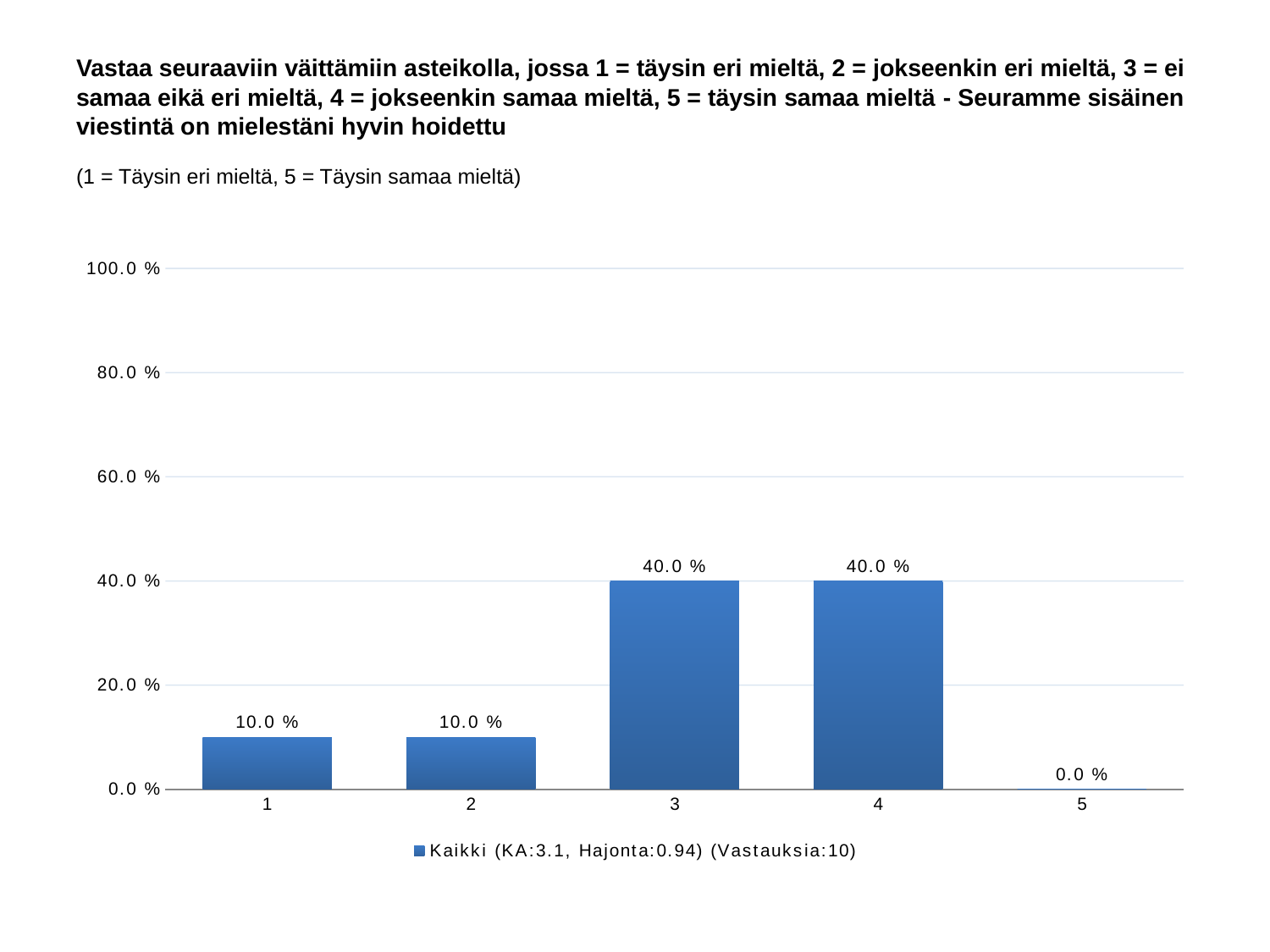
What is the difference between the values for category 3 and category 1? 30.0 % Is the value for category 4 greater or less than 20.0 %? greater Which category has the lowest value? 5 What is the value for category 1? 10.0 % How many series does the legend list? 1 What is the legend entry for the series? Kaikki (KA:3.1, Hajonta:0.94) (Vastauksia:10) What is the value for category 3? 40.0 % Which is larger, the value for category 2 or the value for category 4? 4 What kind of chart is shown? bar chart What is the value for category 5? 0.0 % What is the total of the values for categories 1 and 2? 20.0 % How many categories are shown on the x axis? 5